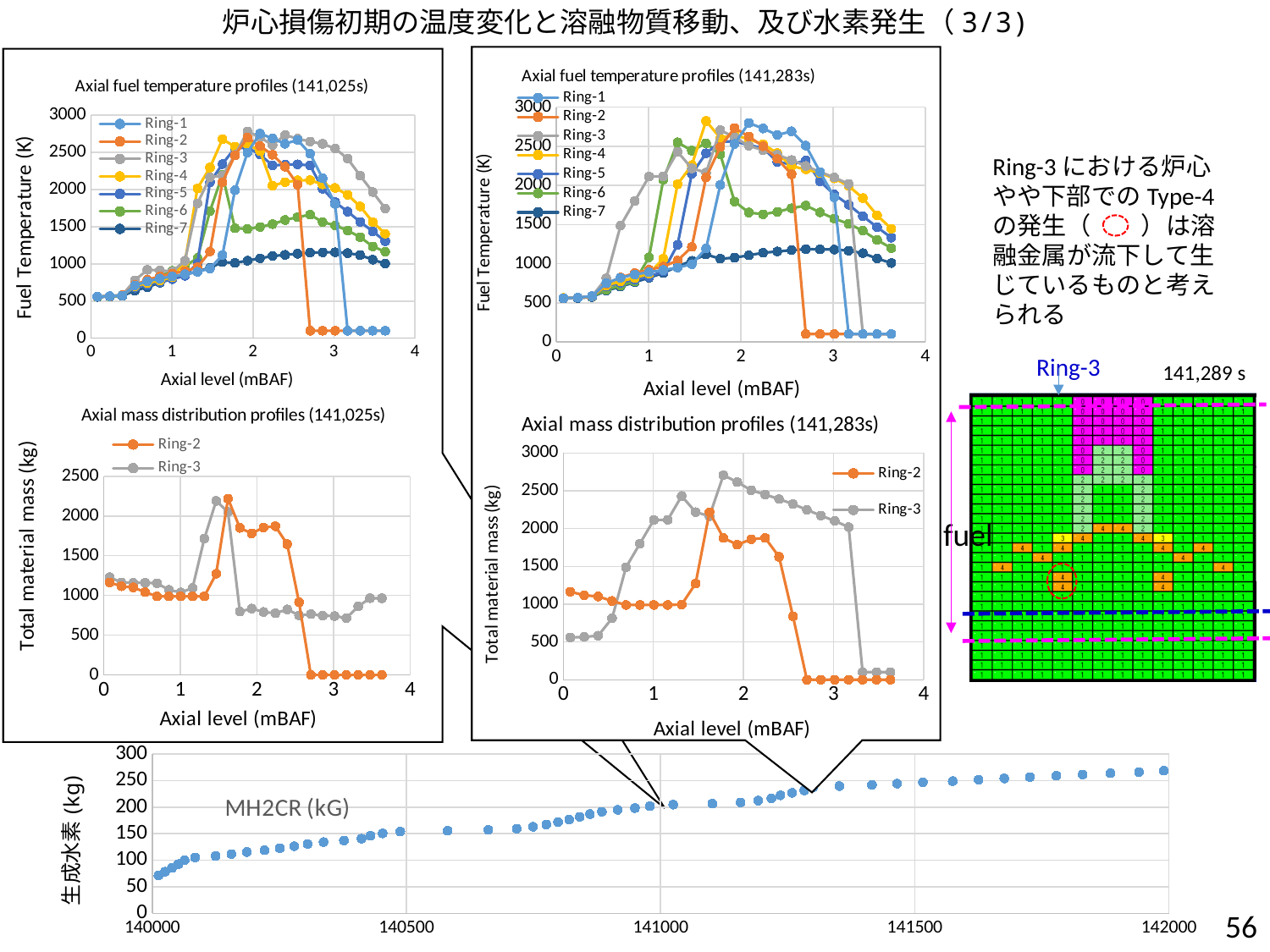
In the bottom chart labelled MH2CR (kG), do the values rise or fall as time increases along the x axis? rise What is the x-axis title of the chart titled "Axial mass distribution profiles (141,025s)"? Axial level (mBAF) In the bottom chart labelled MH2CR (kG), is the value at 142000 greater or less than 250? greater In the bottom chart labelled MH2CR (kG), is the value at 140000 greater or less than 100? less What kind of chart is "Axial fuel temperature profiles (141,283s)"? line chart In the chart titled "Axial mass distribution profiles (141,283s)", how many series does the legend list? 2 In the chart titled "Axial fuel temperature profiles (141,025s)", which series has the lowest peak temperature? Ring-7 In the chart titled "Axial fuel temperature profiles (141,025s)", how many series does the legend list? 7 In the chart titled "Axial fuel temperature profiles (141,283s)", is the peak value of Ring-1 greater or less than 2500? greater